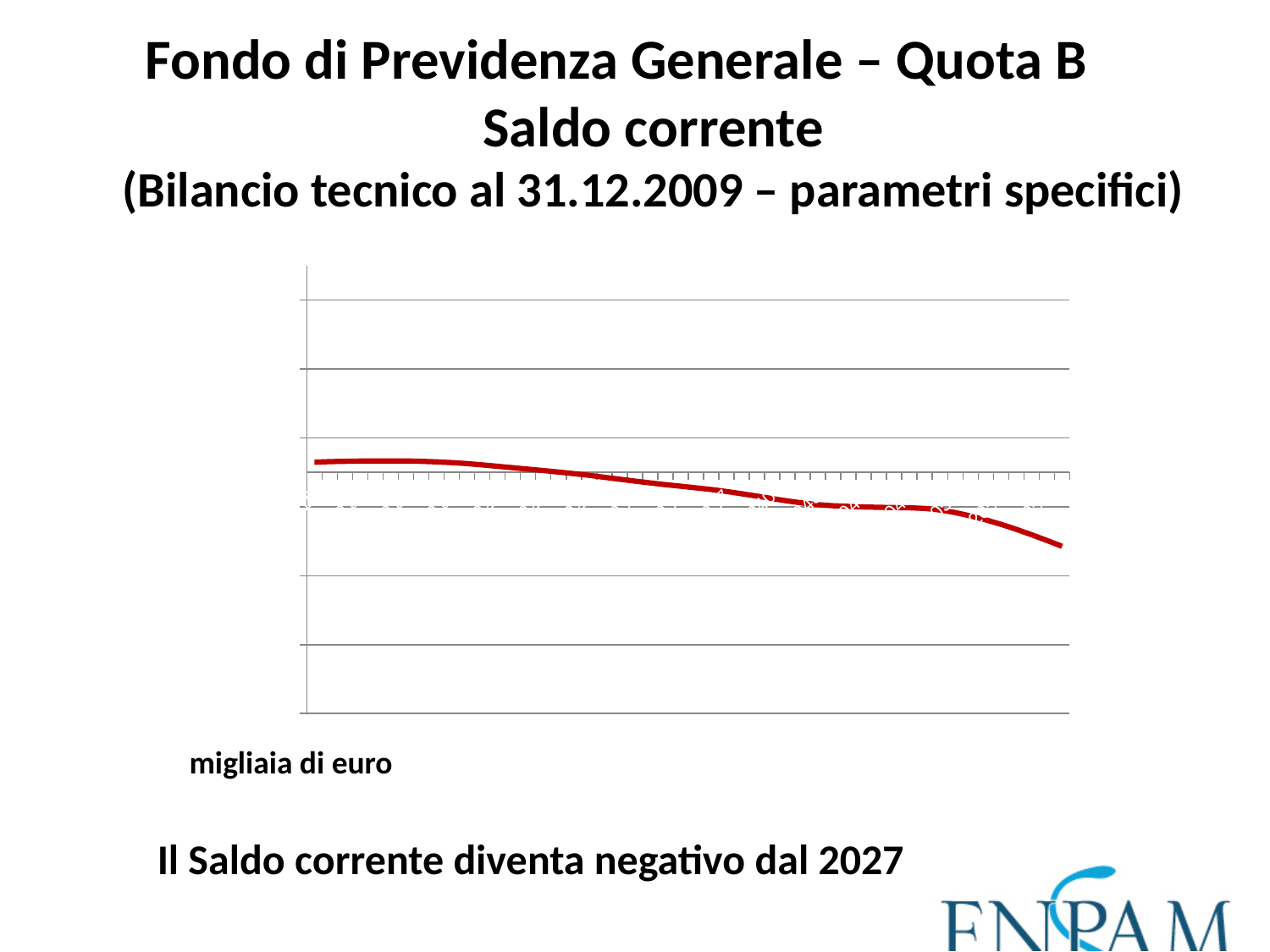
What kind of chart is shown on the slide? line chart How many lines are plotted on the chart? 1 Do the values of the red line generally rise or fall from left to right along the x axis? fall What colour is the plotted line on the chart? red What unit is indicated below the chart? migliaia di euro